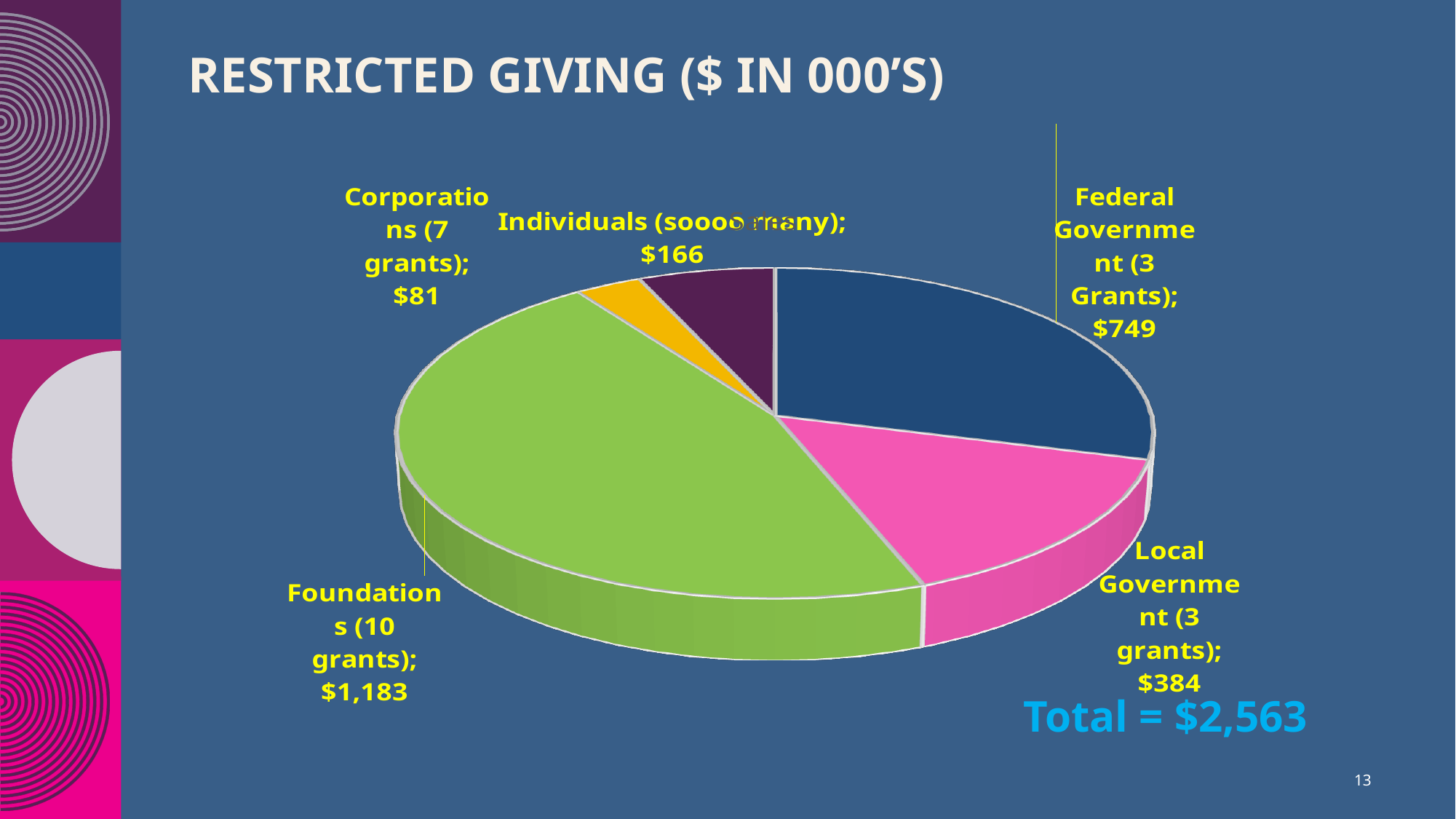
Which category has the smallest slice of the pie? Corporations (7 grants) What type of chart is shown on the slide? Pie chart What is the restricted giving value for Federal Government (3 Grants)? $749 What is the restricted giving value for Individuals? $166 Which category has the largest slice of the pie? Foundations (10 grants) What is the difference between the Federal Government and Local Government values? $365 Which is larger, the value for Individuals or the value for Corporations? Individuals What is the restricted giving value for Foundations (10 grants)? $1,183 How many categories (slices) does the pie chart have? 5 What total is shown for restricted giving on the slide? $2,563 What is the restricted giving value for Local Government (3 grants)? $384 What is the restricted giving value for Corporations (7 grants)? $81